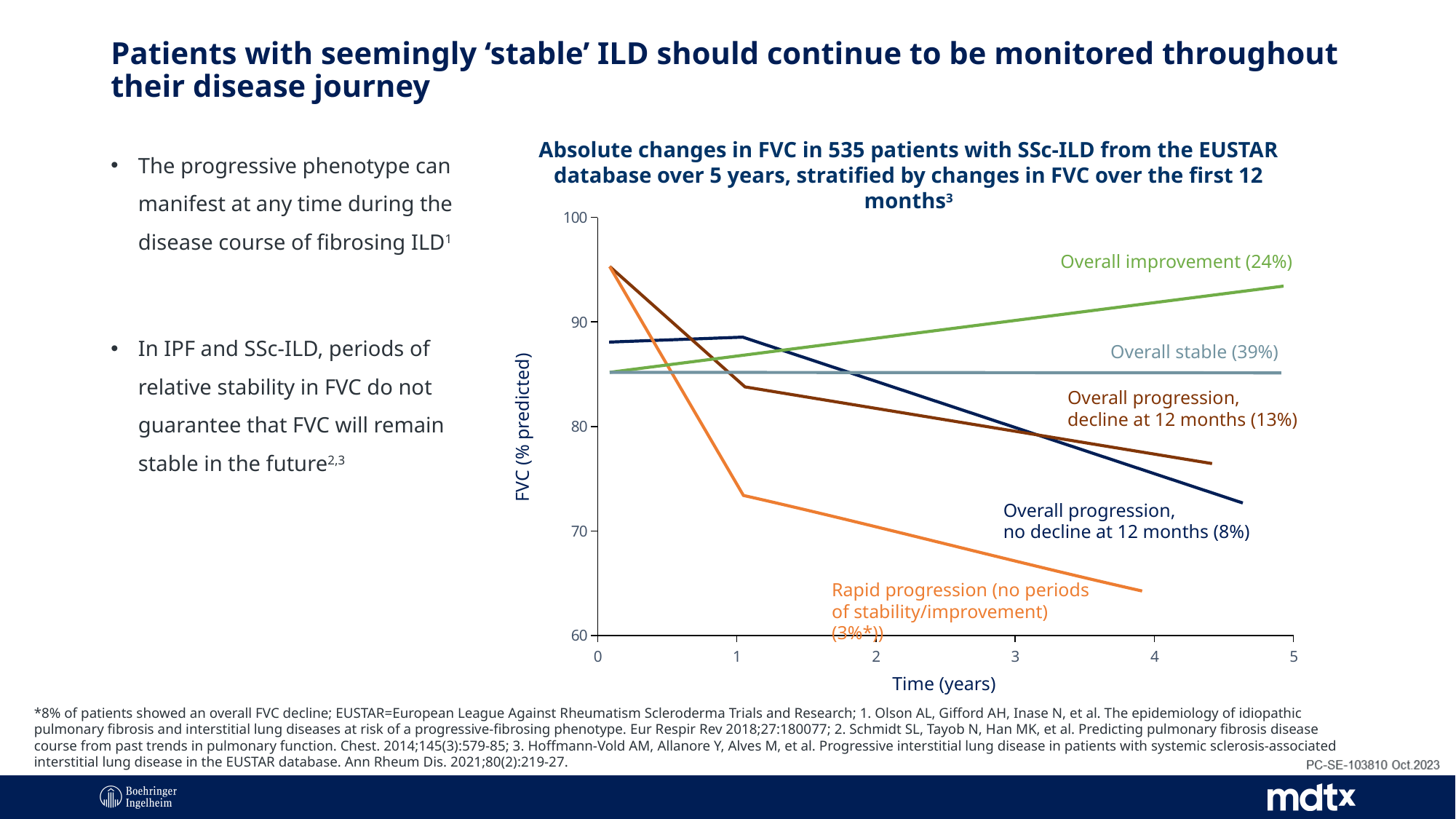
Which line ends at the lowest FVC value at the end of its follow-up? Rapid progression (no periods of stability/improvement) (3%*) What is the label of the x axis of the chart? Time (years) Does the 'Overall improvement (24%)' line rise or fall over time? rise Is the value for the 'Overall stable' line greater or less than 80? greater Does the 'Rapid progression' line rise or fall over time? fall Is the value for the 'Rapid progression' line at year 4 greater or less than 70? less How many lines (patient groups) are plotted on the chart? 5 What percentage of patients is given for the 'Overall stable' group? 39% Is the value for the 'Overall improvement' line at year 5 greater or less than 90? greater What is the label of the y axis of the chart? FVC (% predicted) What kind of chart is shown on the slide? line chart Which line ends at the highest FVC value at year 5? Overall improvement (24%)